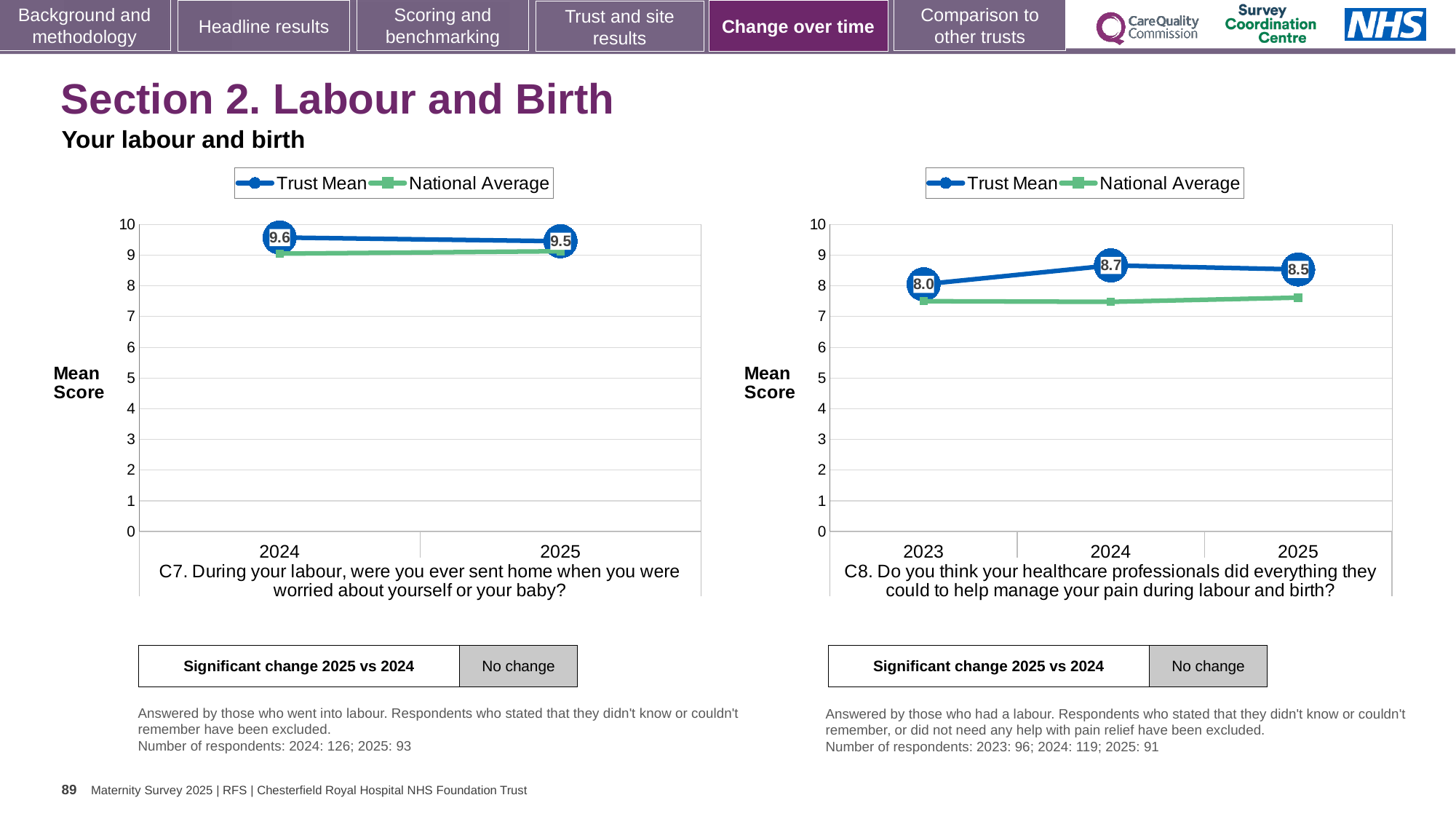
In the C7 chart (left), what is the Trust Mean value for 2024? 9.6 In the C8 chart (right), what is the difference between the Trust Mean for 2024 and 2023? 0.7 In the C7 chart (left), how many years are shown on the x axis? 2 In the C7 chart (left), which is larger in 2025: the Trust Mean or the National Average? Trust Mean In the C8 chart (right), which year has the highest Trust Mean? 2024 In the C8 chart (right), what is the Trust Mean value for 2023? 8.0 In the C7 chart (left), what is the Trust Mean value for 2025? 9.5 In the C8 chart (right), which year has the lowest Trust Mean? 2023 In the C8 chart (right), how many series does the legend list? 2 In the C8 chart (right), what is the Trust Mean value for 2024? 8.7 In the C8 chart (right), is the National Average value for 2023 greater or less than 8? less What type of chart is the C7 chart on the left? Line chart